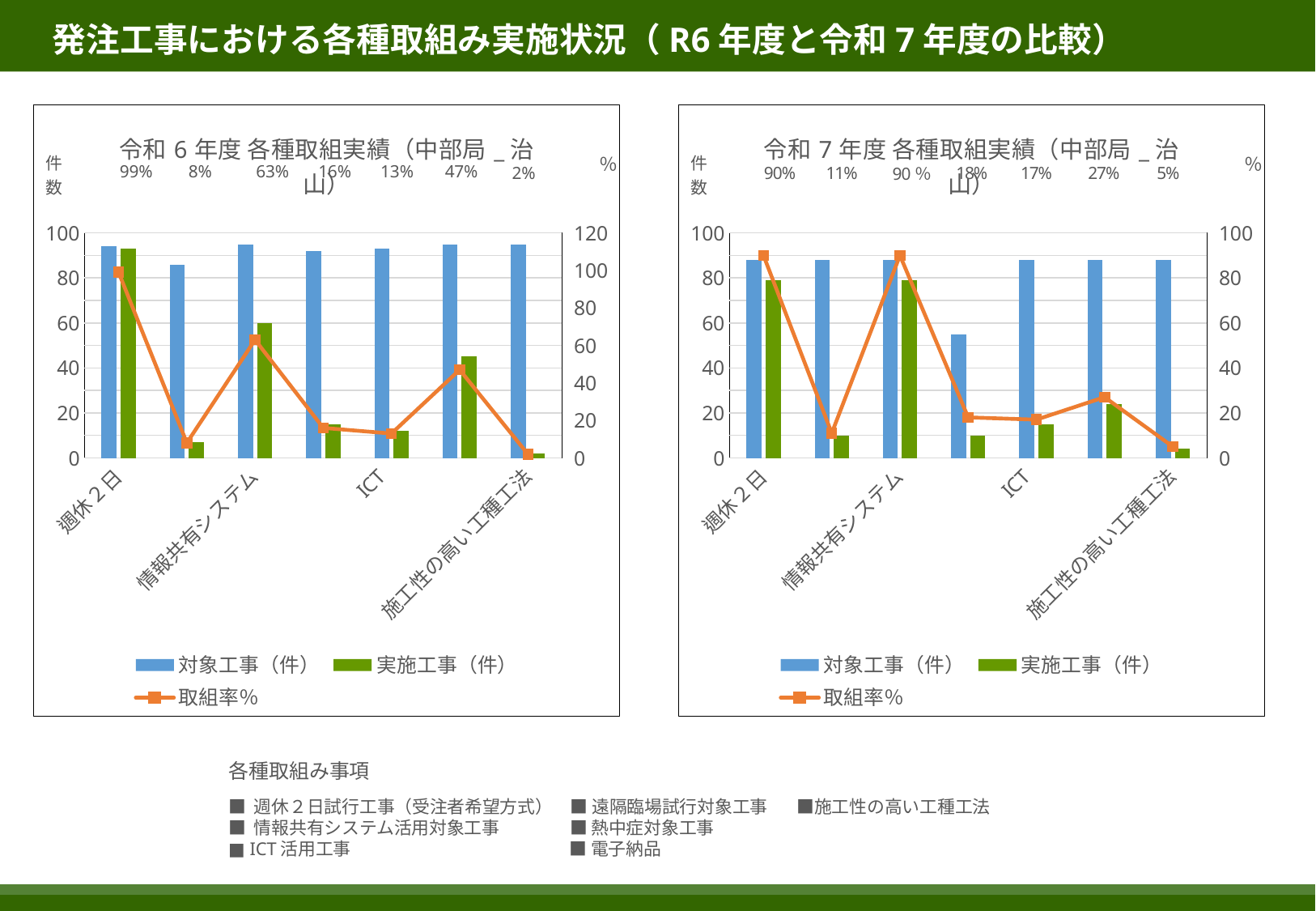
In the right chart (令和7年度), is the 対象工事（件） value for ICT greater or less than 80? greater How many series does the legend of the right chart (令和7年度) list? 3 In the right chart (令和7年度), which category has the lowest 取組率%? 施工性の高い工種工法 How many categories are plotted on the x axis of the left chart (令和6年度)? 7 In the left chart (令和6年度), which has the larger 取組率%, ICT or 施工性の高い工種工法? ICT In the left chart (令和6年度), what is the 取組率% for 週休2日? 99% In the left chart (令和6年度), what is the 取組率% for 情報共有システム? 63% In the left chart (令和6年度), what is the difference between the 取組率% for 週休2日 and for 情報共有システム? 36% In the right chart (令和7年度), what is the 取組率% for 施工性の高い工種工法? 5% What kind of chart is the left chart (令和6年度)? Combined bar and line chart In the right chart (令和7年度), what is the 取組率% for ICT? 17% In the left chart (令和6年度), which category has the highest 取組率%? 週休2日